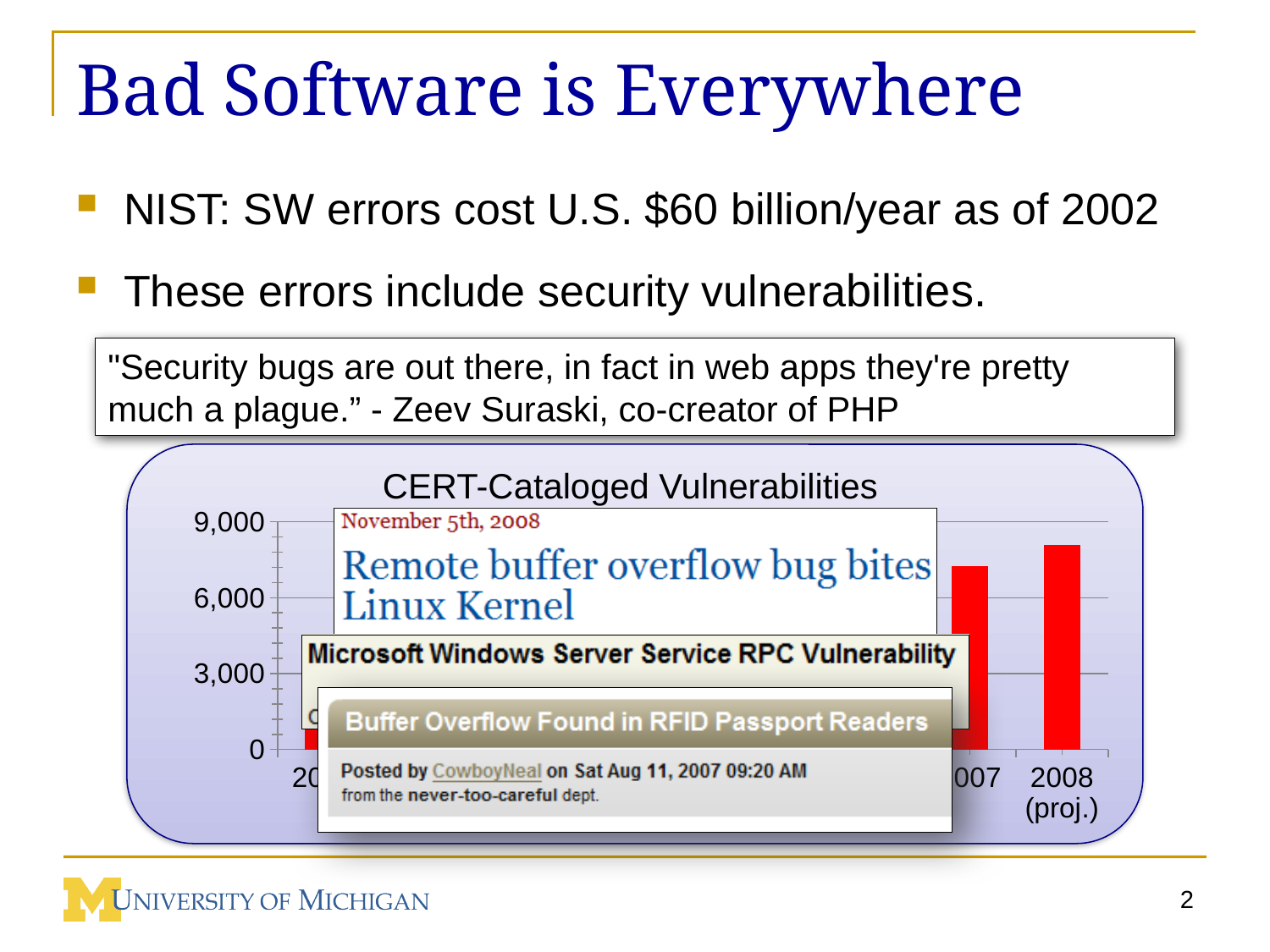
Is the value for 2008 (proj.) greater or less than 9,000? less What is the title of the chart on the slide? CERT-Cataloged Vulnerabilities Which is larger, the value for 2007 or the value for 2008 (proj.)? 2008 (proj.) What is the highest value labelled on the y axis of the chart? 9,000 What colour are the bars in the chart? red Is the value for 2007 greater or less than 6,000? greater What kind of chart is shown on the slide? bar chart Is the value for 2008 (proj.) greater or less than 6,000? greater